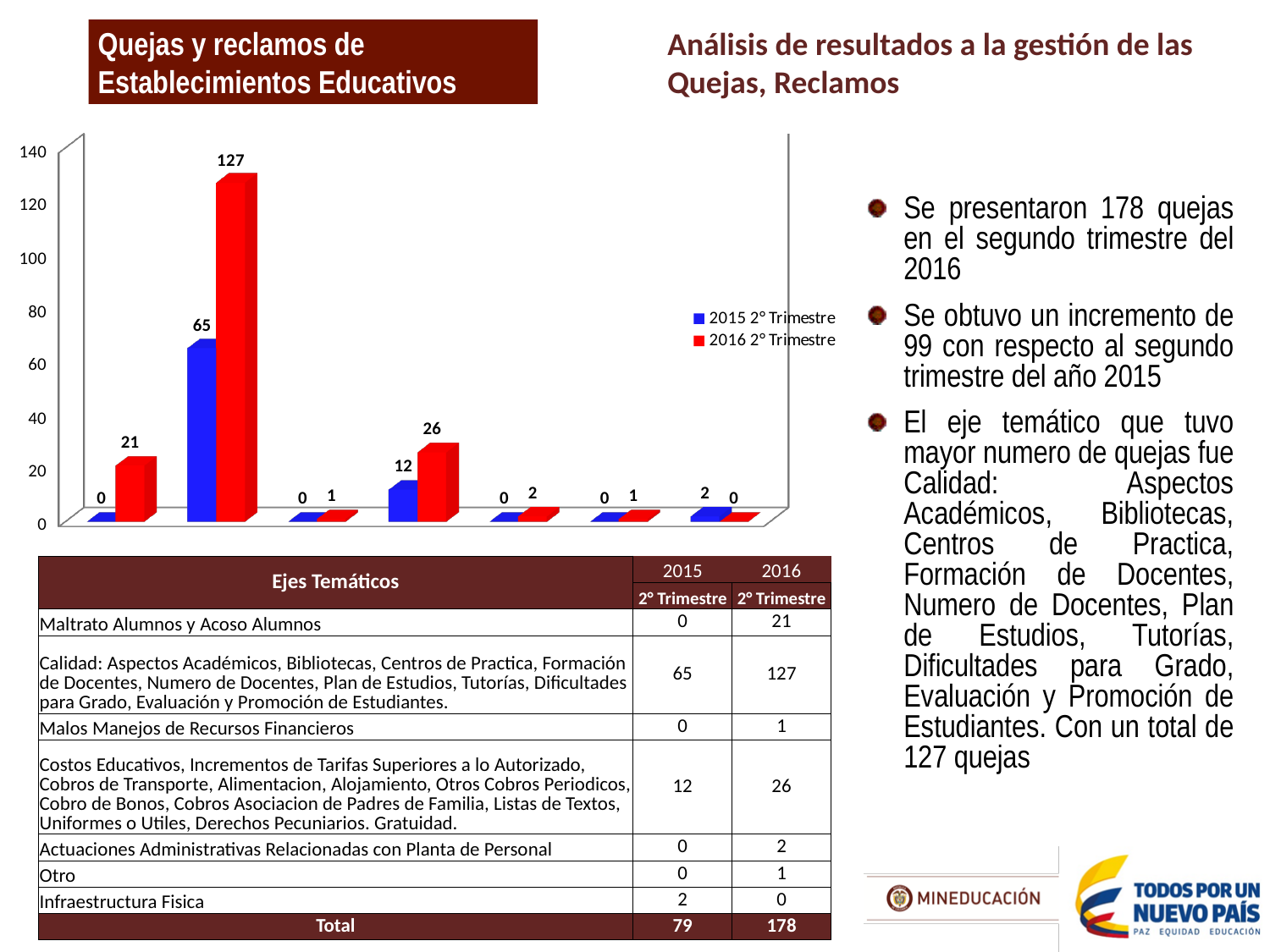
What is the 2016 2° Trimestre value for 'Maltrato Alumnos y Acoso Alumnos' (the first group of bars)? 21 How many series does the chart legend list? 2 What is the 2016 2° Trimestre value for the category 'Calidad: Aspectos Académicos...' (the second group of bars)? 127 What are the two series named in the chart legend? 2015 2° Trimestre and 2016 2° Trimestre What type of chart is shown on the slide? bar chart What is the difference between the 2016 2° Trimestre and 2015 2° Trimestre values in the second group of bars (127 and 65)? 62 What is the 2015 2° Trimestre value for the category 'Costos Educativos...' (the fourth group of bars)? 12 How many categories (groups of bars) are plotted in the chart? 7 What is the difference between the 2016 and 2015 values in the fourth group of bars (26 and 12)? 14 What is the highest value labelled on any bar in the chart? 127 Which is larger: the 2016 2° Trimestre value for 'Maltrato Alumnos y Acoso Alumnos' or for 'Costos Educativos...'? Costos Educativos Is the 2016 2° Trimestre value for the second group of bars greater or less than 100? greater